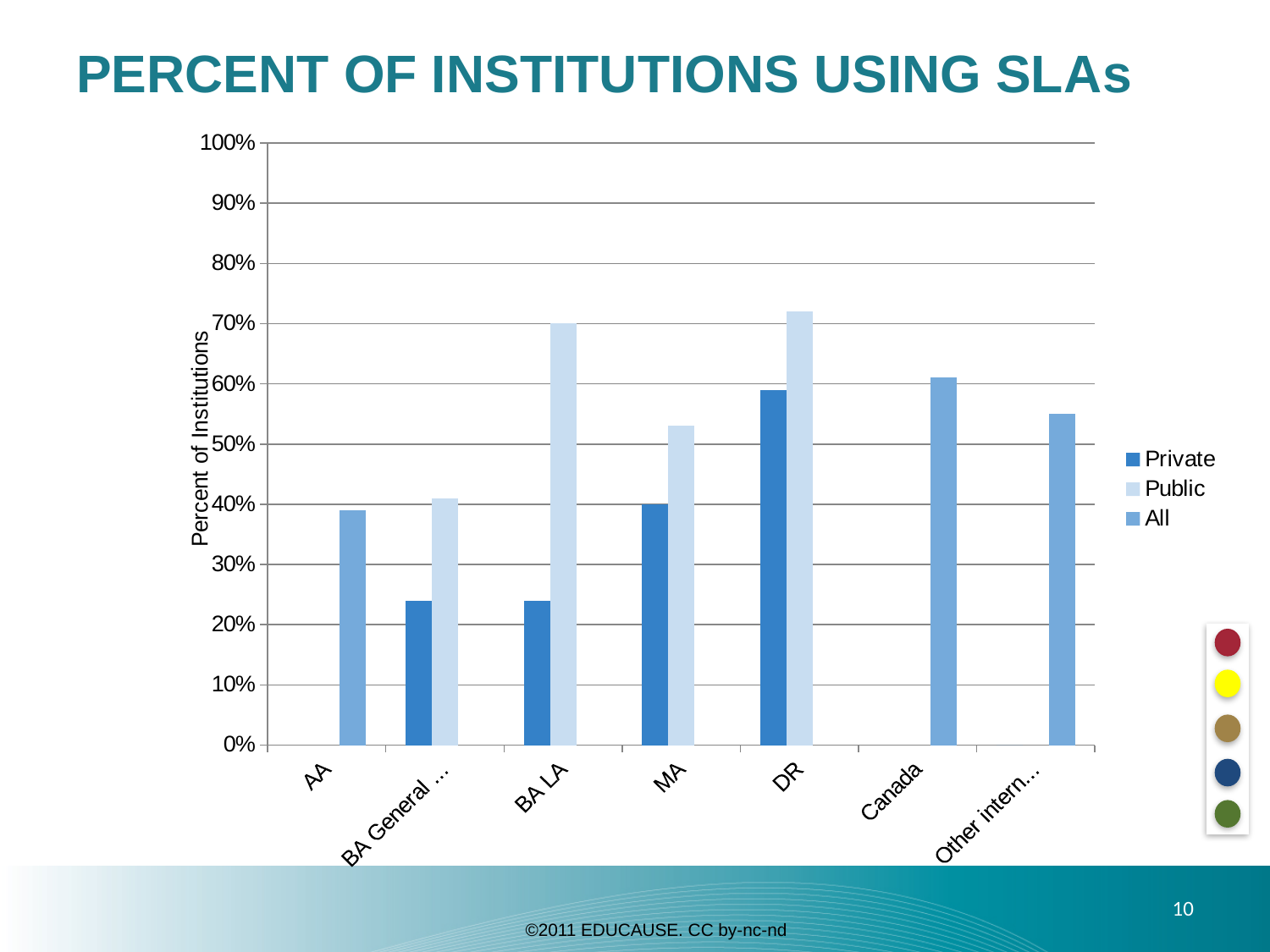
Which category has the highest Private value? DR Which is larger, the All value for Canada or the All value for AA? Canada What kind of chart is shown on the slide? bar chart How many categories are shown on the x axis? 7 Is the Private value for BA LA greater or less than 30%? less Is the Public value for DR greater or less than 70%? greater Which category has the highest Public value? DR How many series does the legend list? 3 Which is larger for MA, the Private value or the Public value? Public What is the label of the y axis? Percent of Institutions